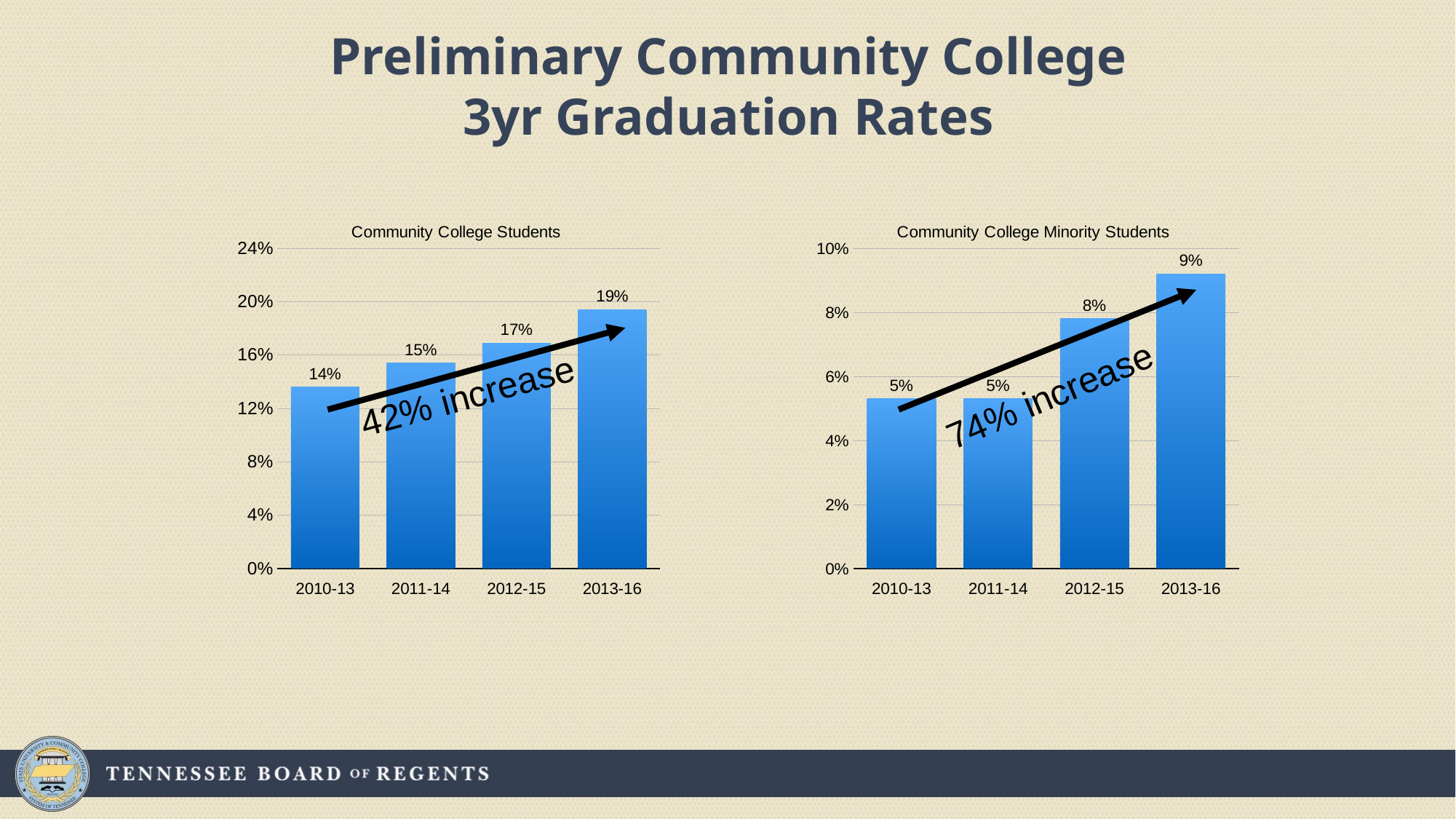
How many periods are shown on the x axis of the 'Community College Students' chart? 4 In the 'Community College Minority Students' chart, is the value for 2013-16 greater or less than 8%? greater In the 'Community College Minority Students' chart, which period has the highest graduation rate? 2013-16 What kind of chart is the 'Community College Minority Students' chart? bar chart In the 'Community College Minority Students' chart, what is the difference between the 2013-16 and 2011-14 values? 4% In the 'Community College Students' chart, which period has the lowest graduation rate? 2010-13 In the 'Community College Minority Students' chart, what is the value for 2012-15? 8% What percentage increase is annotated on the 'Community College Minority Students' chart? 74% increase In the 'Community College Students' chart, what is the value for 2013-16? 19% In the 'Community College Students' chart, do the values rise or fall from 2010-13 to 2013-16? rise In the 'Community College Students' chart, what is the difference between the 2013-16 and 2010-13 values? 5% In the 'Community College Students' chart, which is larger, the value for 2011-14 or the value for 2012-15? 2012-15